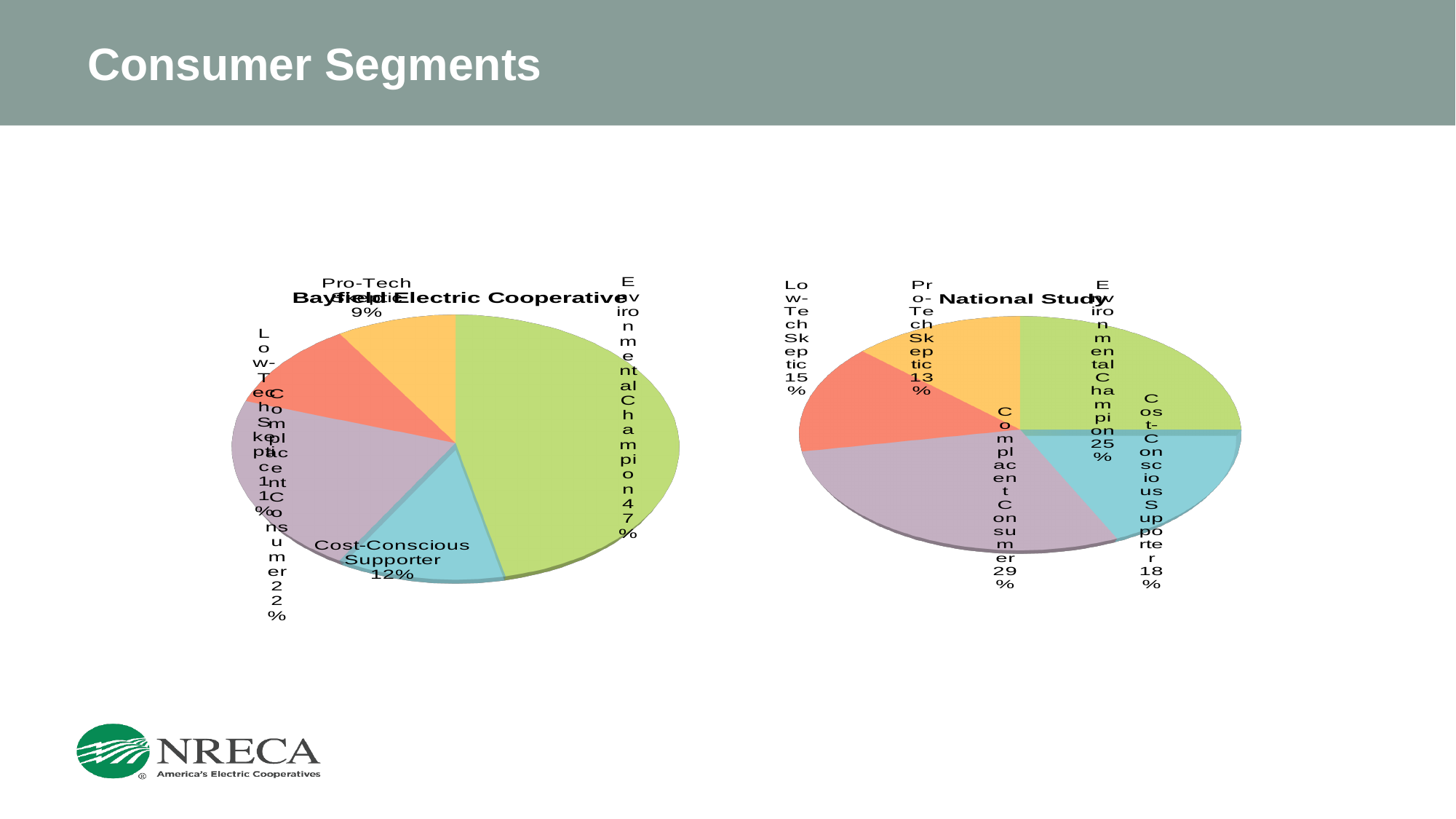
In the Bayfield Electric Cooperative chart, what share is Pro-Tech Skeptic? 9% How many segments does the National Study pie chart have? 5 In the National Study chart, what is the difference between Low-Tech Skeptic and Pro-Tech Skeptic? 2% What type of chart is the Bayfield Electric Cooperative chart? pie chart In the Bayfield Electric Cooperative chart, which segment has the largest share? Environmental Champion In the Bayfield Electric Cooperative chart, what share is Cost-Conscious Supporter? 12% In the National Study chart, what share is Cost-Conscious Supporter? 18% In the National Study chart, which segment has the largest share? Complacent Consumer In the National Study chart, what share is Environmental Champion? 25% In the National Study chart, what share is Complacent Consumer? 29% In the Bayfield Electric Cooperative chart, which segment has the smallest share? Pro-Tech Skeptic In the Bayfield Electric Cooperative chart, what share is Environmental Champion? 47%